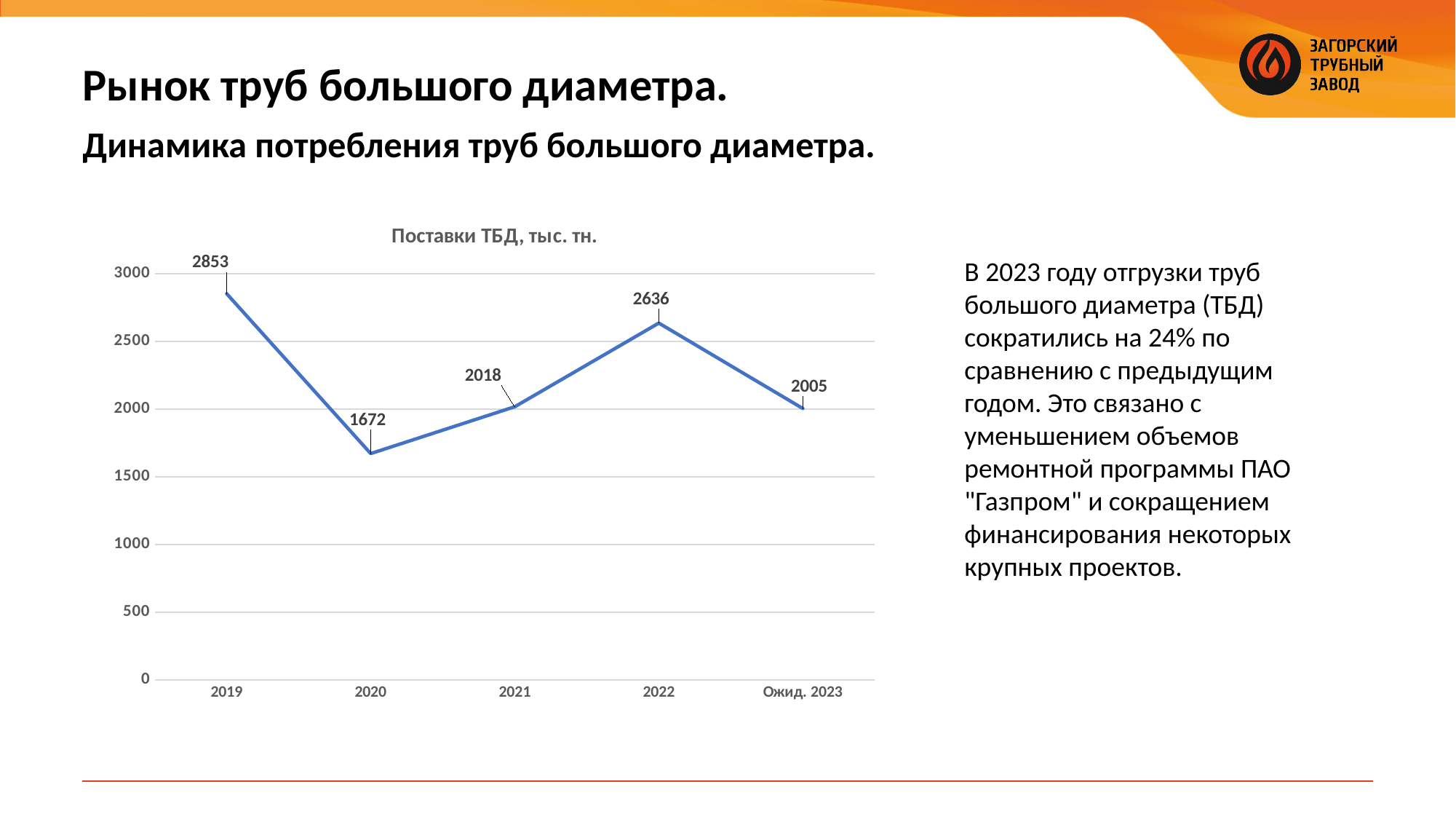
How many data points are plotted in the chart? 5 What is the difference between the values for 2022 and Ожид. 2023? 631 What is the difference between the values for 2019 and 2020? 1181 What type of chart is shown on the slide? line chart What is the value for Ожид. 2023 in the chart? 2005 Which is larger, the value for 2021 or the value for 2022? 2022 What is the value for 2021 in the chart? 2018 What is the value for 2020 in the chart? 1672 What is the value for 2022 in the chart? 2636 Which year has the lowest value in the chart? 2020 What is the value for 2019 in the chart? 2853 Which year has the highest value in the chart? 2019